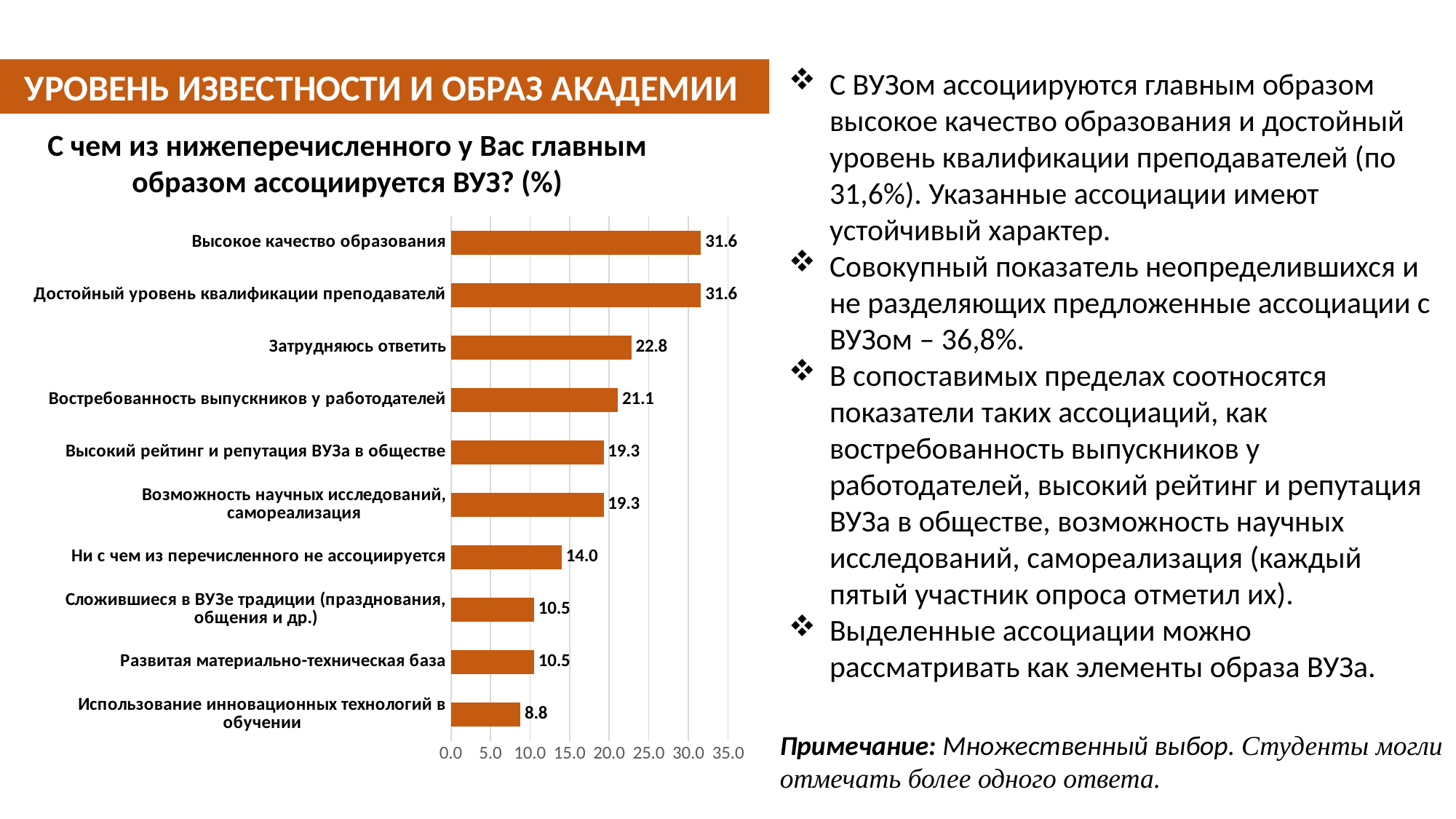
What is the value for «Использование инновационных технологий в обучении»? 8.8 Which is larger: «Высокий рейтинг и репутация ВУЗа в обществе» or «Ни с чем из перечисленного не ассоциируется»? Высокий рейтинг и репутация ВУЗа в обществе Is the value for «Достойный уровень квалификации преподавателей» greater or less than 30.0? greater What is the difference between «Высокое качество образования» and «Затрудняюсь ответить»? 8.8 What is the value for «Затрудняюсь ответить»? 22.8 Which category has the lowest value? Использование инновационных технологий в обучении What kind of chart is shown on the slide? bar chart What is the title of the chart? С чем из нижеперечисленного у Вас главным образом ассоциируется ВУЗ? (%) What is the value for «Ни с чем из перечисленного не ассоциируется»? 14.0 What is the value for «Востребованность выпускников у работодателей»? 21.1 How many categories are shown in the chart? 10 What is the difference between «Востребованность выпускников у работодателей» and «Развитая материально-техническая база»? 10.6